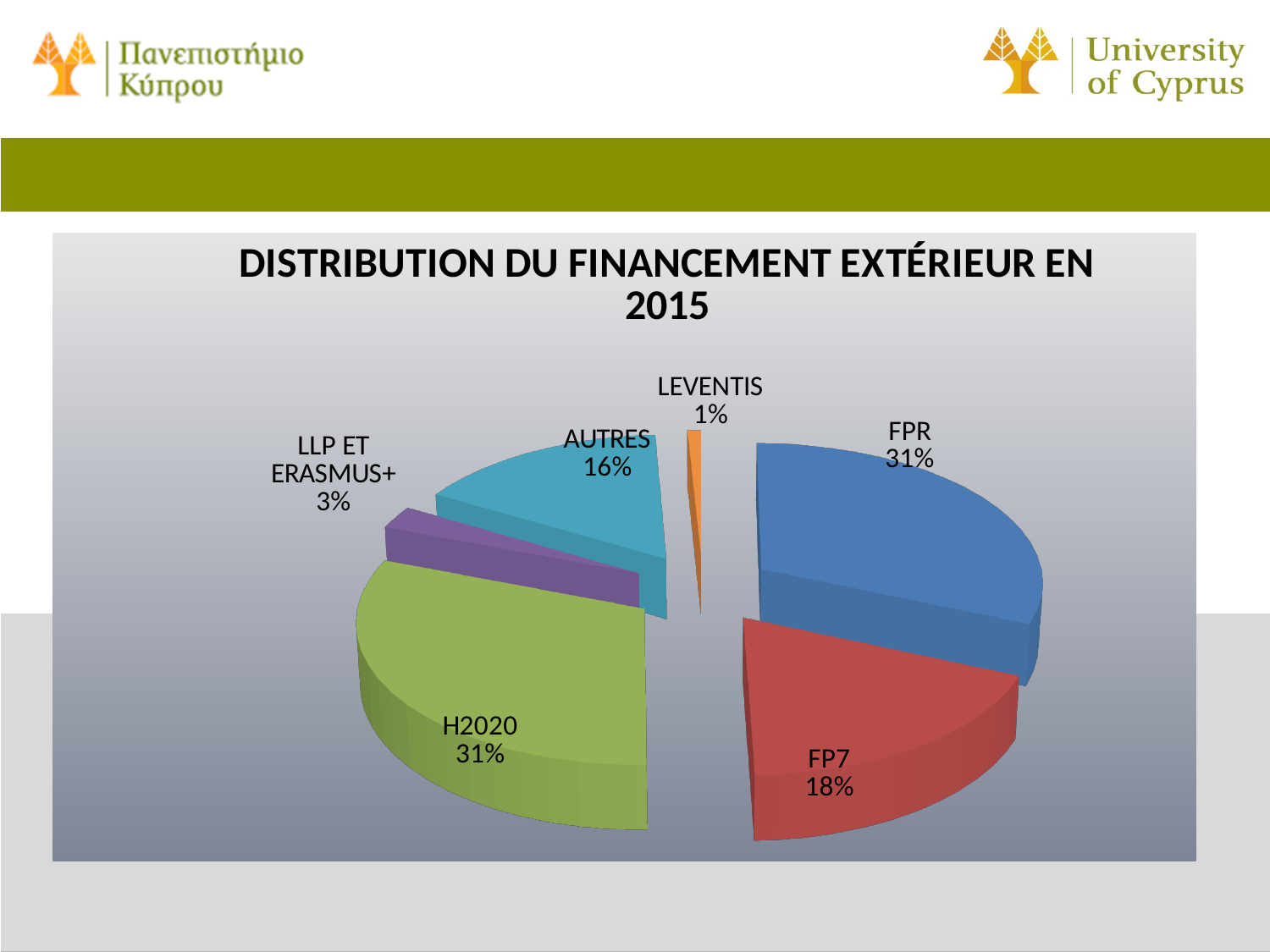
What share of the pie does FPR represent? 31% How many slices does the pie chart have? 6 What kind of chart is shown on the slide? Pie chart What share of the pie does H2020 represent? 31% Which category has the smallest share of the pie? LEVENTIS What share of the pie does LEVENTIS represent? 1% Which is larger, the share for FP7 or the share for AUTRES? FP7 By how many percentage points does the FP7 share exceed the AUTRES share? 2 percentage points What is the title of the chart? DISTRIBUTION DU FINANCEMENT EXTÉRIEUR EN 2015